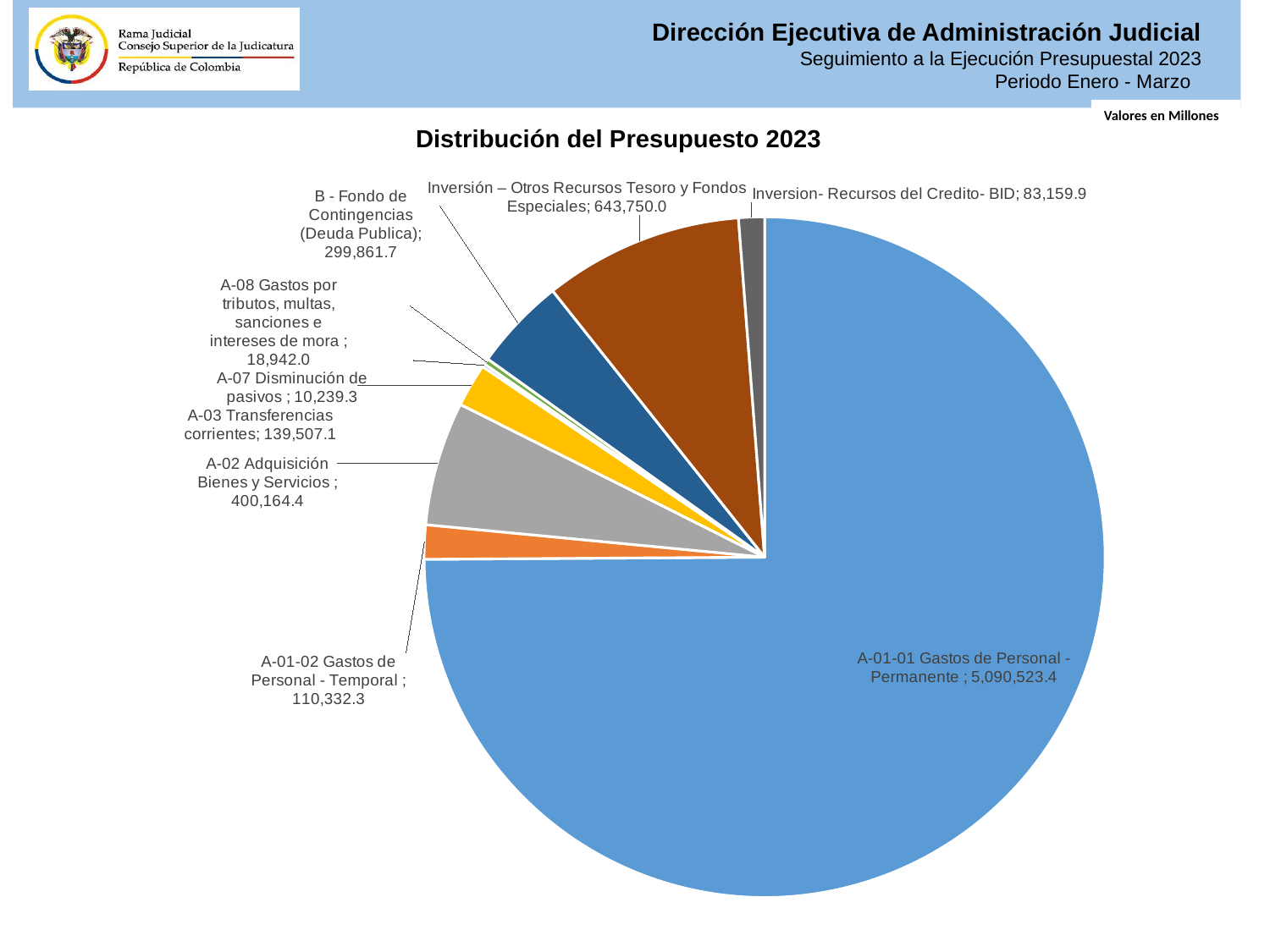
What is the difference between Inversión – Otros Recursos Tesoro y Fondos Especiales and B - Fondo de Contingencias (Deuda Publica)? 343,888.3 What is the value for A-02 Adquisición Bienes y Servicios? 400,164.4 How many slices does the pie chart have? 9 What is the value for A-07 Disminución de pasivos? 10,239.3 Which category has the largest slice of the pie? A-01-01 Gastos de Personal - Permanente Which is larger, B - Fondo de Contingencias (Deuda Publica) or A-03 Transferencias corrientes? B - Fondo de Contingencias (Deuda Publica) What is the title of the chart? Distribución del Presupuesto 2023 What is the difference between A-02 Adquisición Bienes y Servicios and A-03 Transferencias corrientes? 260,657.3 What is the value for Inversión – Otros Recursos Tesoro y Fondos Especiales? 643,750.0 Which category has the smallest slice of the pie? A-07 Disminución de pasivos What kind of chart is shown on the slide? Pie chart What is the value for A-01-01 Gastos de Personal - Permanente? 5,090,523.4